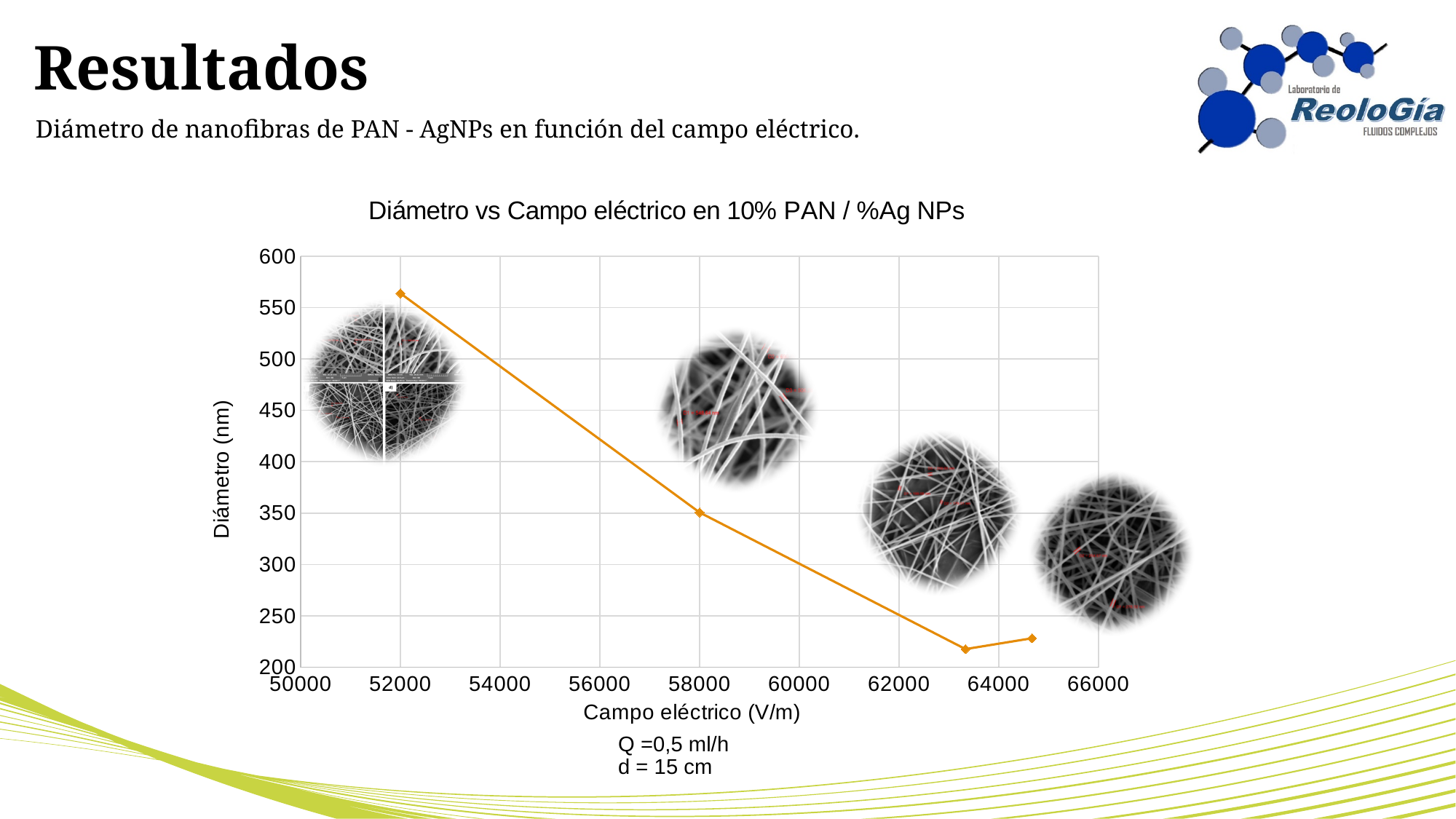
How many data points are plotted on the chart? 4 Is the diameter at an electric field of 58000 V/m greater or less than 300 nm? greater Which has the larger diameter: the point at 52000 V/m or the point at 58000 V/m? 52000 V/m Does the diameter generally rise or fall as the electric field increases along the x axis? Fall What is the label of the y axis? Diámetro (nm) What kind of chart is shown on the slide? Line chart Is the diameter at an electric field of 52000 V/m greater or less than 500 nm? greater Is the lowest plotted diameter greater or less than 250 nm? less What is the title of the chart? Diámetro vs Campo eléctrico en 10% PAN / %Ag NPs At which electric field value is the plotted diameter highest? 52000 V/m